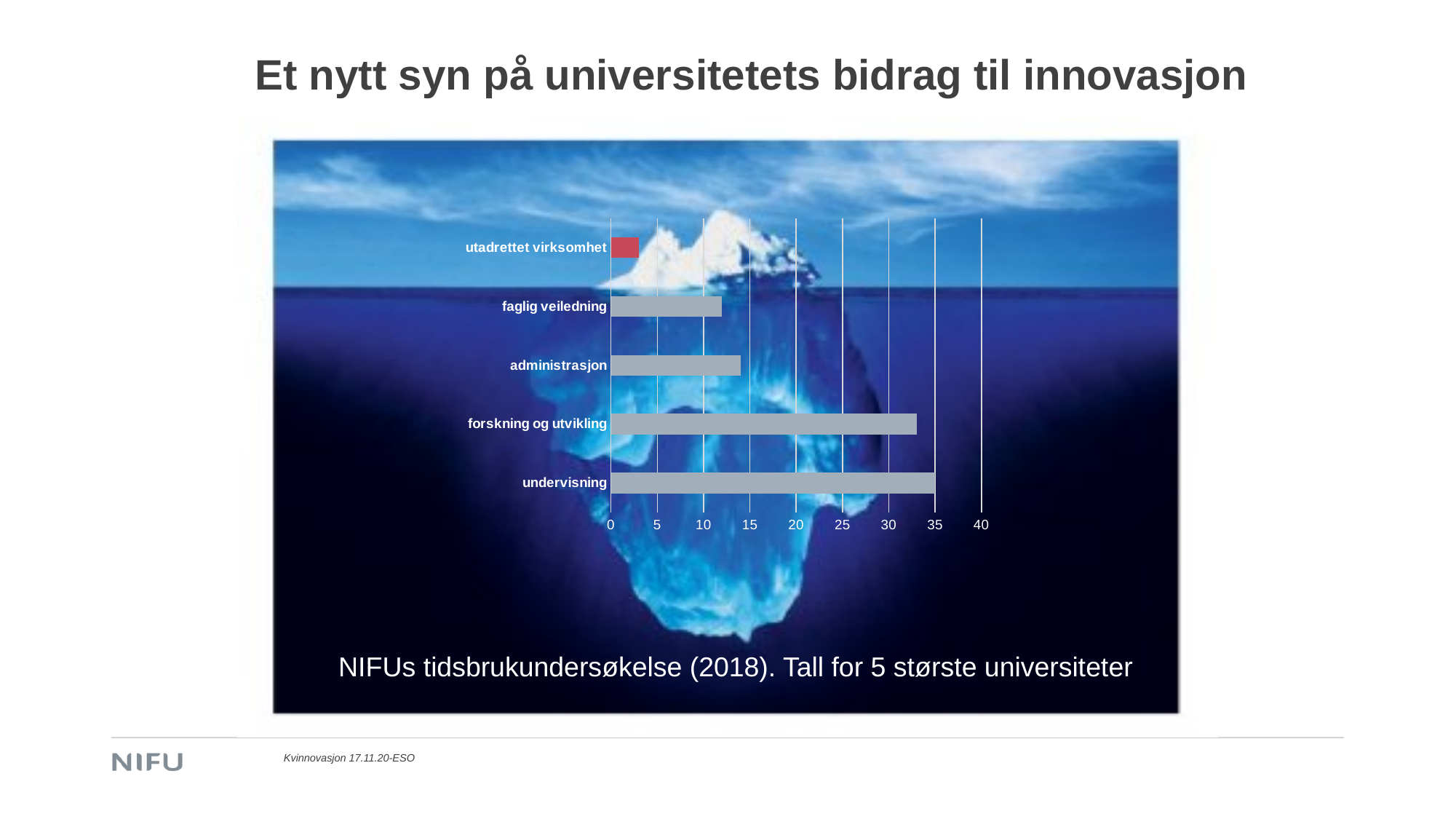
Is the value for forskning og utvikling greater or less than 30? greater Which category has the highest value? undervisning Is the value for faglig veiledning greater or less than 10? greater What is the highest value shown on the x axis? 40 Which category has the lowest value? utadrettet virksomhet Which is larger, the value for undervisning or the value for faglig veiledning? undervisning What colour is the bar for utadrettet virksomhet? red What kind of chart is shown on the slide? bar chart Is the value for administrasjon greater or less than 15? less How many categories are plotted in the chart? 5 Which is larger, the value for administrasjon or the value for faglig veiledning? administrasjon